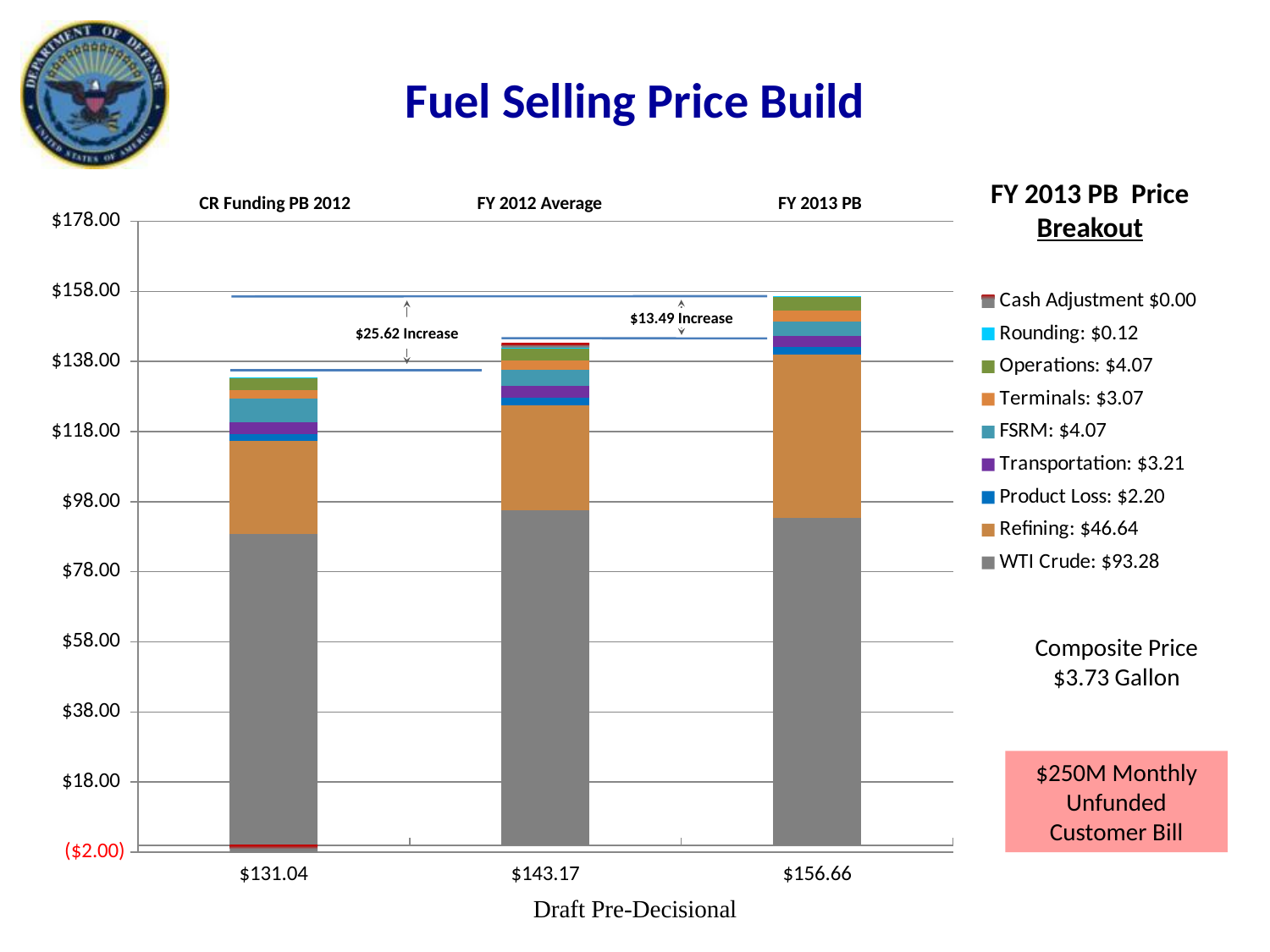
What is the total value of the CR Funding PB 2012 bar? $131.04 Which bar has the highest total value? FY 2013 PB Do the bar totals rise or fall from left to right across the chart? Rise What kind of chart is shown on the slide? Stacked bar chart Is the WTI Crude segment of the CR Funding PB 2012 bar greater or less than $98.00? less According to the legend, what is the Refining value in the FY 2013 PB price breakout? $46.64 Which bar has the lowest total value? CR Funding PB 2012 What is the difference between the FY 2013 PB total and the FY 2012 Average total? $13.49 How many bars (categories) are plotted in the chart? 3 According to the legend, what is the WTI Crude value in the FY 2013 PB price breakout? $93.28 What is the total value of the FY 2013 PB bar? $156.66 How many series does the chart legend list? 9